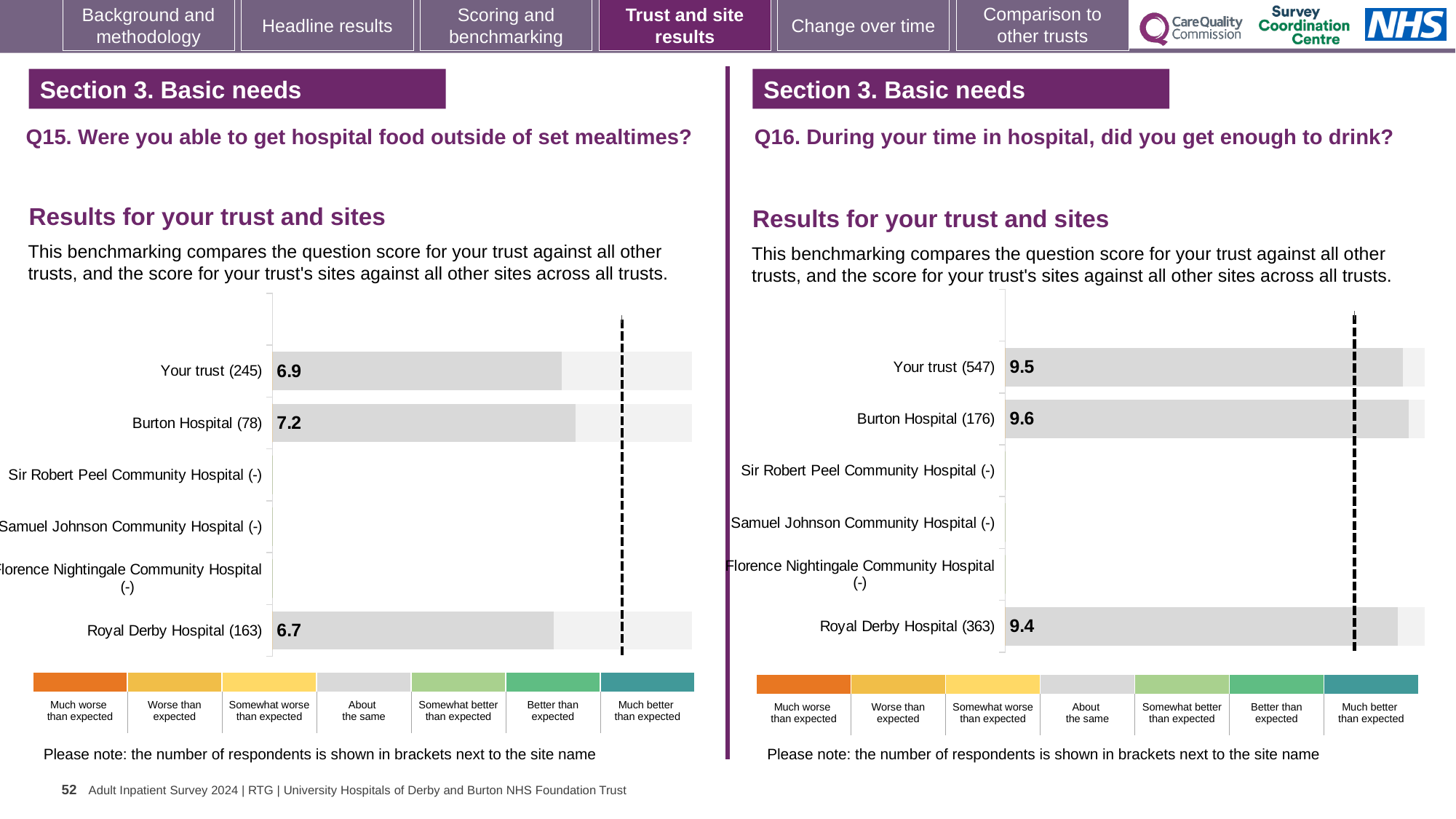
In the Q15 chart on the left, what is the score for Your trust? 6.9 What kind of chart is used on the Q16 chart on the right? Bar chart In the Q15 chart on the left, what is the difference between the Burton Hospital score and the Royal Derby Hospital score? 0.5 In the Q16 chart on the right, how many respondents are shown in brackets for Burton Hospital? 176 In the Q15 chart on the left, which site or trust row has the highest score? Burton Hospital In the Q16 chart on the right, what is the score for Your trust? 9.5 In the Q15 chart on the left, what is the score for Royal Derby Hospital? 6.7 How many rows (trust and sites) are listed on the Q15 chart on the left? 6 In the Q16 chart on the right, which row has the lowest score? Royal Derby Hospital In the Q16 chart on the right, which is larger: the score for Burton Hospital or the score for Your trust? Burton Hospital In the Q15 chart on the left, what is the score for Burton Hospital? 7.2 In the Q16 chart on the right, what is the score for Royal Derby Hospital? 9.4